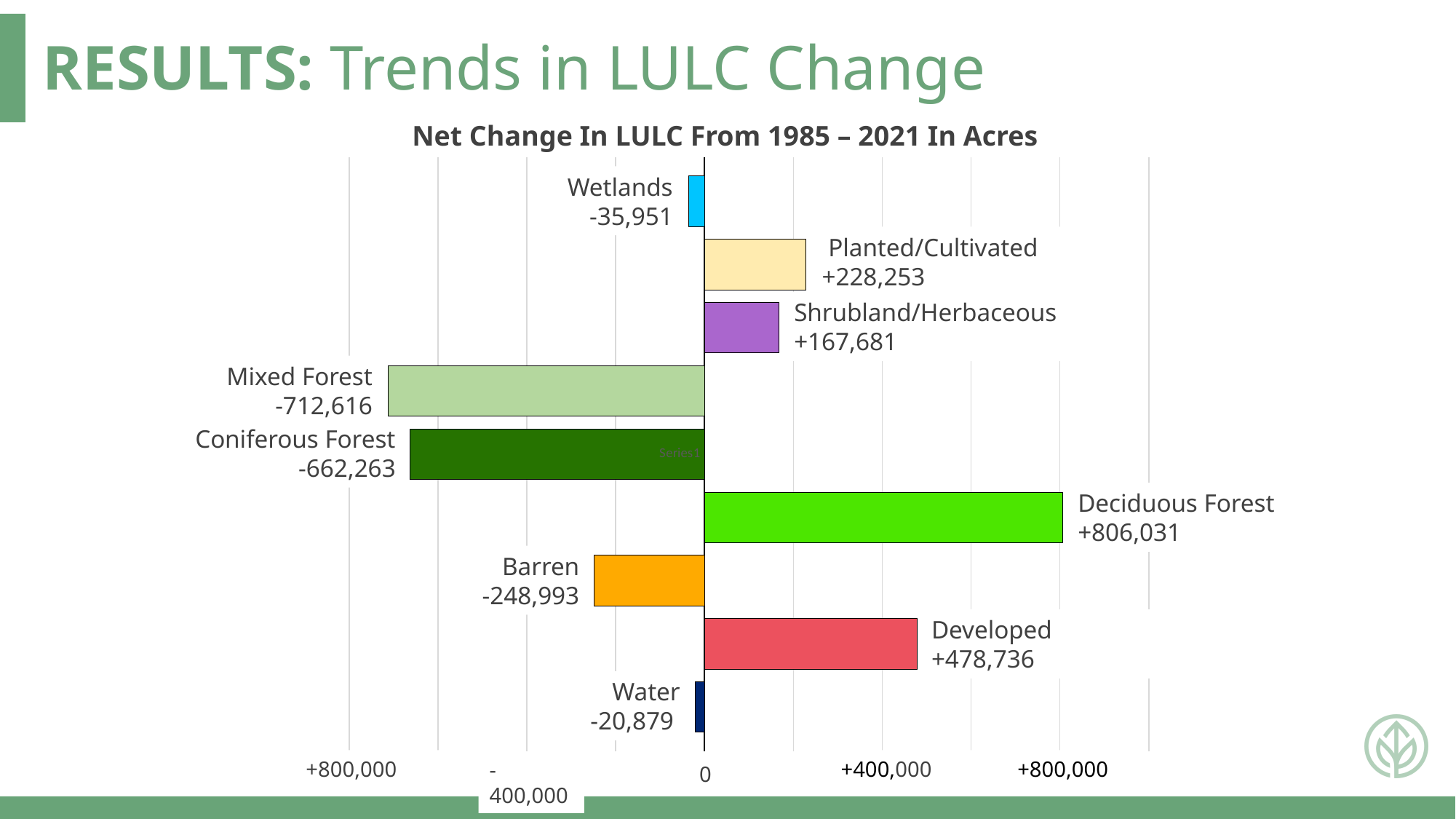
What is the net change in acres for Mixed Forest? -712,616 Which has a larger net gain in acres, Developed or Planted/Cultivated? Developed What is the difference between the net change for Deciduous Forest and Developed? 327,295 What kind of chart is shown on the slide? Bar chart What is the net change in acres for Barren land? -248,993 How many land cover categories are shown in the chart? 9 What is the net change in acres for Water? -20,879 What is the title of the chart? Net Change In LULC From 1985 – 2021 In Acres Which land cover category has the largest negative net change (lowest value)? Mixed Forest What is the net change in acres for Deciduous Forest? +806,031 Which land cover category has the largest positive net change? Deciduous Forest What is the difference between the net change for Planted/Cultivated and Shrubland/Herbaceous? 60,572